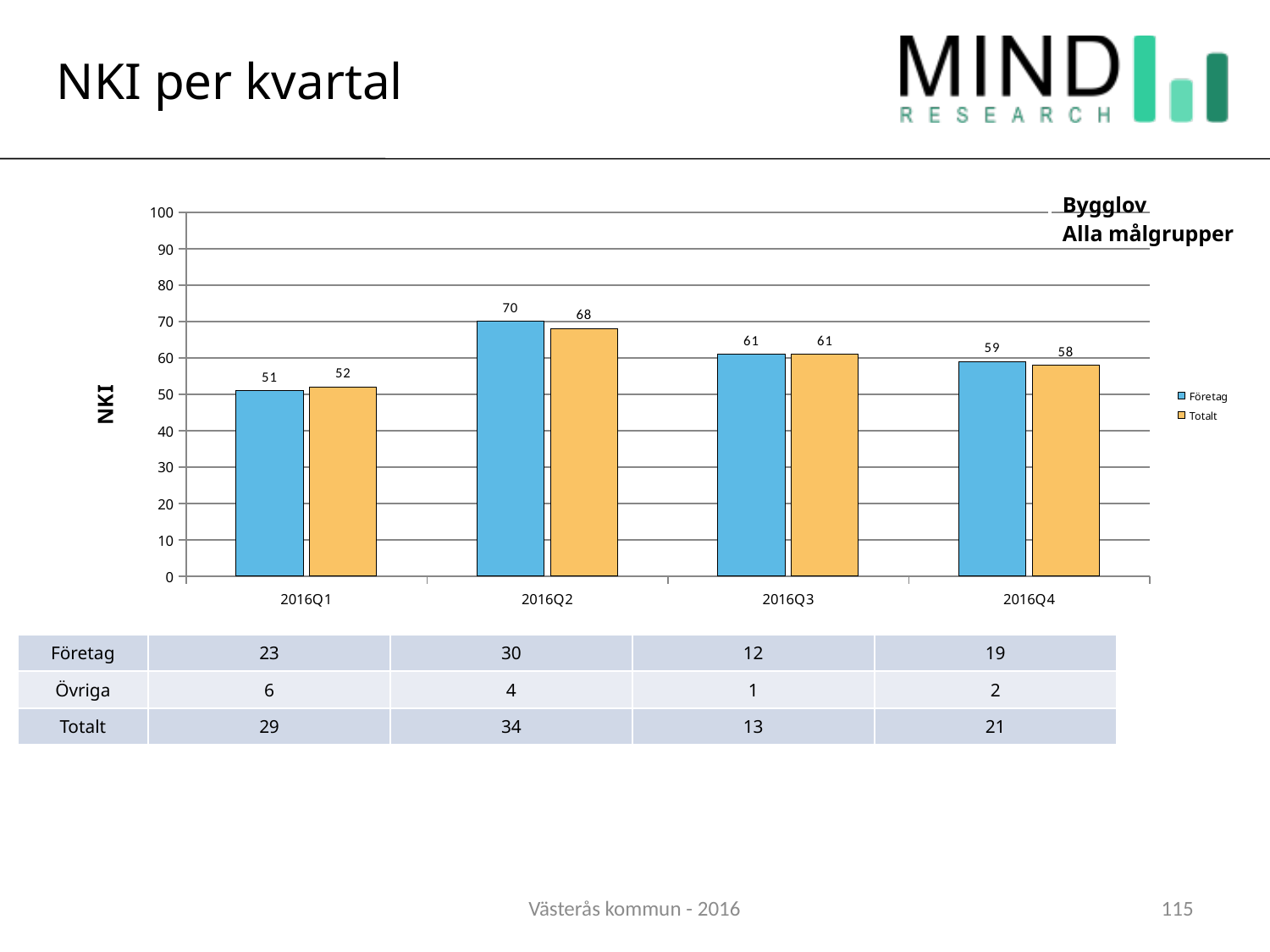
What is the Totalt value for 2016Q4? 58 Which quarter has the lowest Totalt value? 2016Q1 Which quarter has the highest Företag value? 2016Q2 Which is larger, the Företag value for 2016Q3 or the Företag value for 2016Q4? 2016Q3 How many series does the legend list? 2 What is the difference between the Företag values for 2016Q2 and 2016Q1? 19 What is the Totalt value for 2016Q1? 52 What is the Företag value for 2016Q2? 70 How many quarters are shown on the x axis? 4 What kind of chart is shown on the slide? bar chart Is the Totalt value for 2016Q2 greater or less than 60? greater What is the label on the y axis? NKI